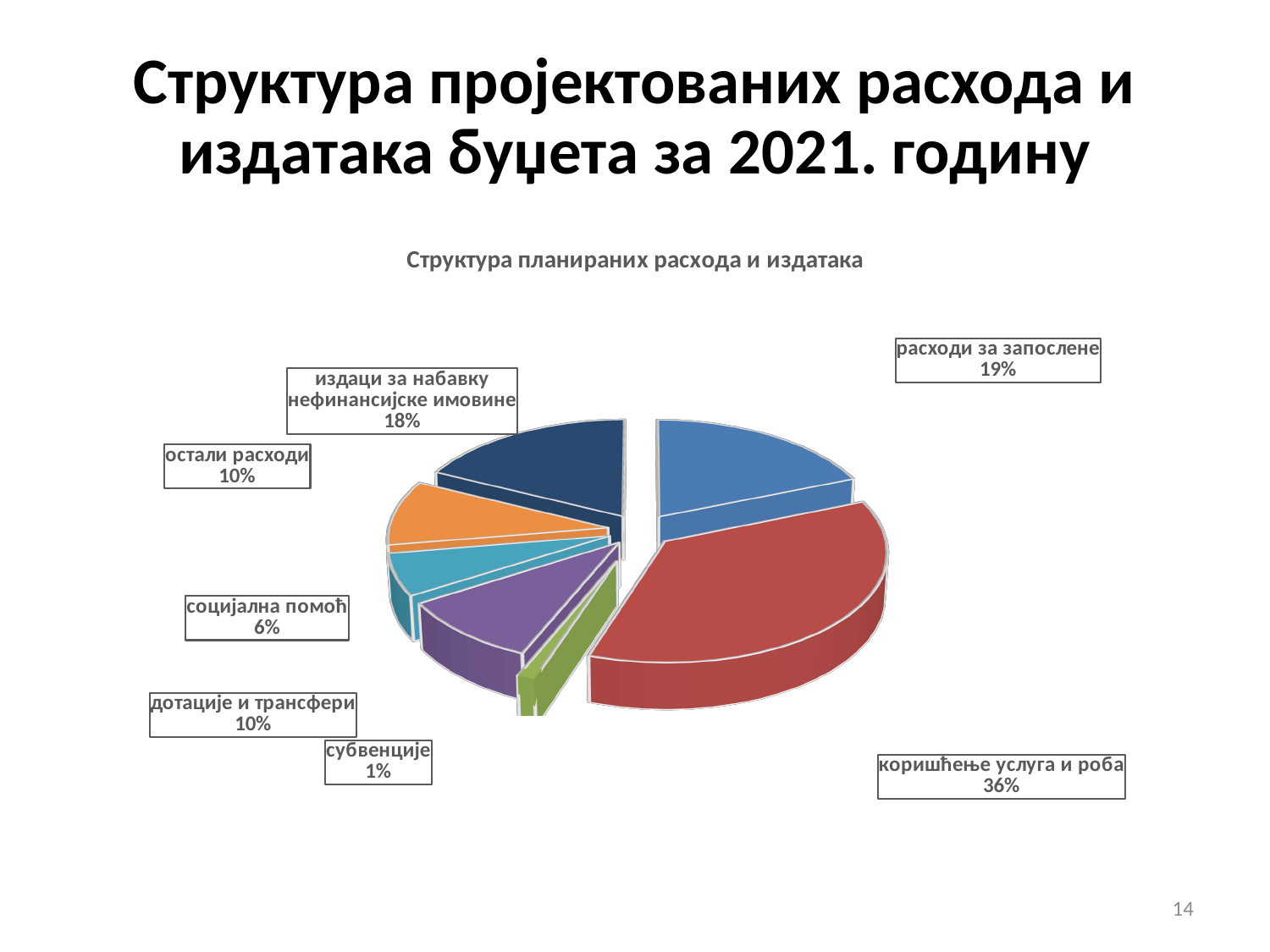
What is the difference in percentage points between коришћење услуга и роба and расходи за запослене? 17 What share of the pie is коришћење услуга и роба? 36% How many slices does the pie chart have? 7 What share of the pie is издаци за набавку нефинансијске имовине? 18% What share of the pie is социјална помоћ? 6% Which is larger, the share for остали расходи or the share for социјална помоћ? остали расходи Which category has the smallest share of the pie? субвенције What kind of chart is shown on the slide? pie chart What is the title of the chart? Структура планираних расхода и издатака Which category has the largest share of the pie? коришћење услуга и роба